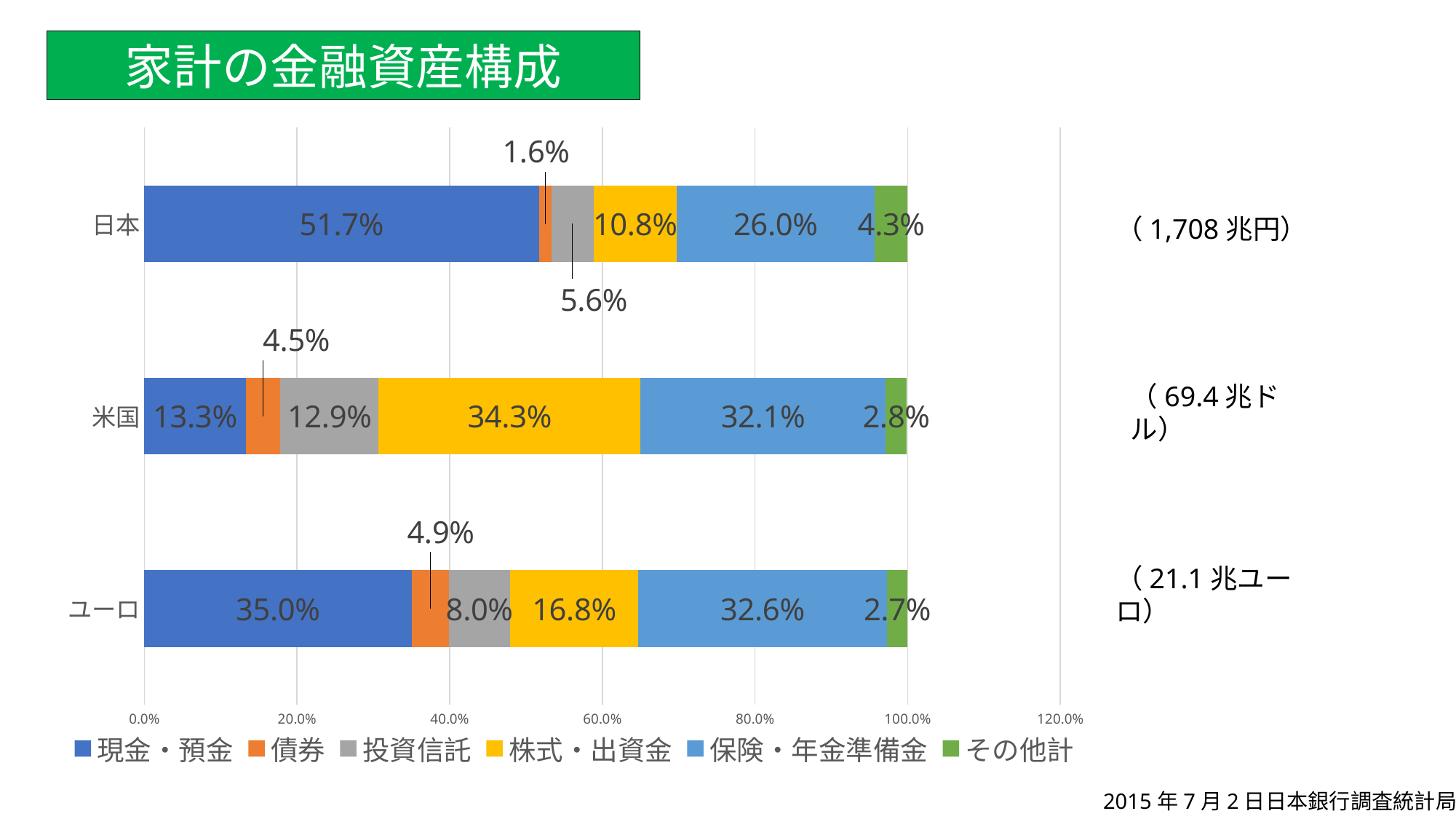
How many series does the legend list? 6 What is the difference between the 現金・預金 share of 日本 and that of 米国? 38.4% What type of chart is shown on the slide? Stacked bar chart Which region has the highest share of 現金・預金? 日本 What is the title of the chart? 家計の金融資産構成 What is the share of 債券 for 日本? 1.6% What is the share of 保険・年金準備金 for ユーロ? 32.6% What is the share of 現金・預金 for 日本? 51.7% Which region has the lowest share of 株式・出資金? 日本 What is the share of 株式・出資金 for 米国? 34.3% Which is larger: the 投資信託 share of 米国 or the 投資信託 share of ユーロ? 米国 How many regions (categories) are shown in the chart? 3